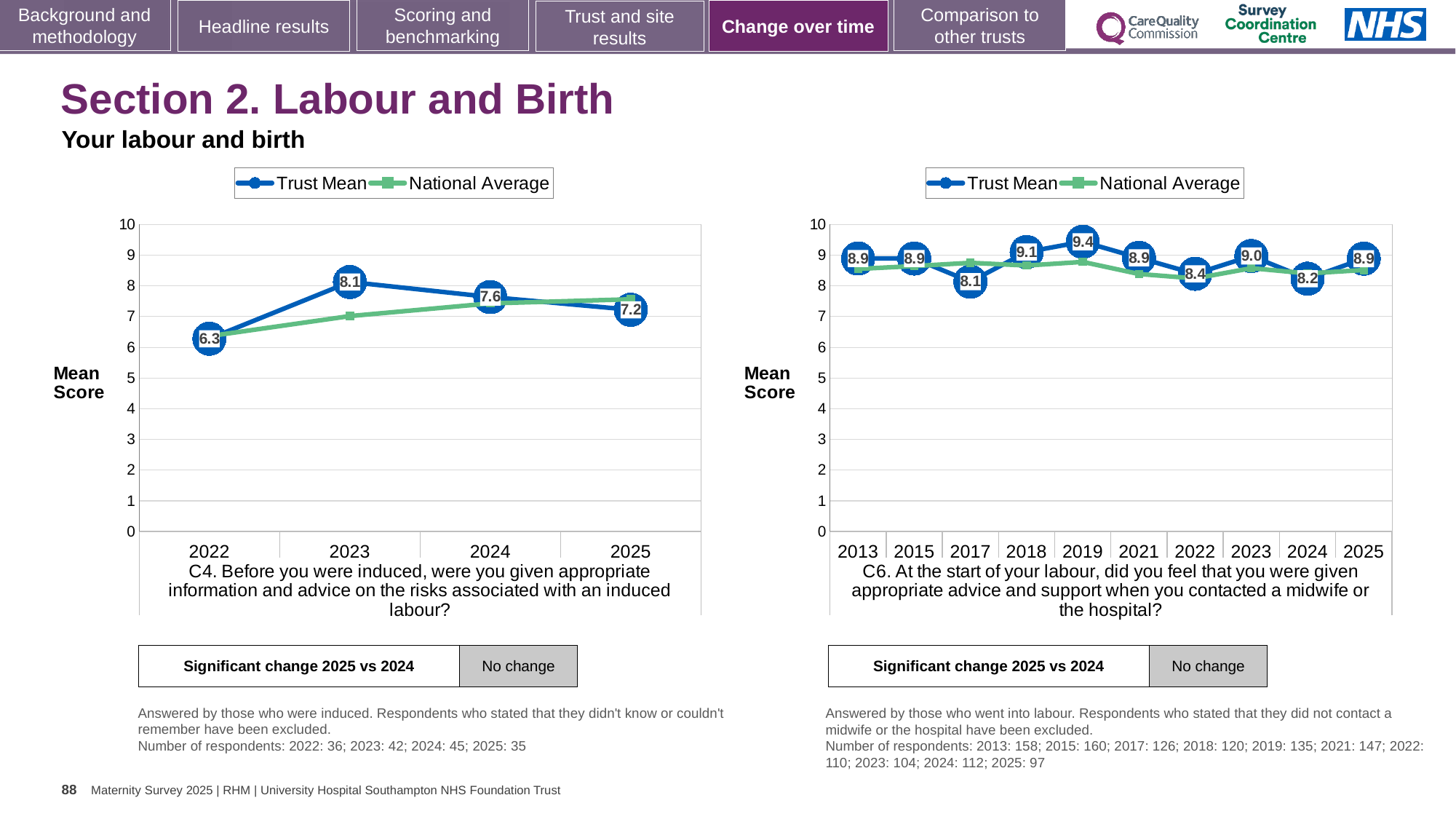
In the right chart (C6), is the Trust Mean score for 2023 larger than the Trust Mean score for 2024? Yes In the left chart (C4), which year has the lowest Trust Mean score? 2022 In the right chart (C6), what is the Trust Mean score for 2019? 9.4 In the right chart (C6), how many series does the legend list? 2 In the right chart (C6), which year has the highest Trust Mean score? 2019 In the left chart (C4), what is the Trust Mean score for 2025? 7.2 In the left chart (C4), what is the difference between the Trust Mean scores for 2023 and 2022? 1.8 In the left chart (C4), is the National Average for 2022 greater or less than 7? less In the left chart (C4), how many years are shown on the x axis? 4 What type of chart is used on the right (C6)? Line chart In the left chart (C4), what is the Trust Mean score for 2023? 8.1 In the right chart (C6), what is the Trust Mean score for 2017? 8.1